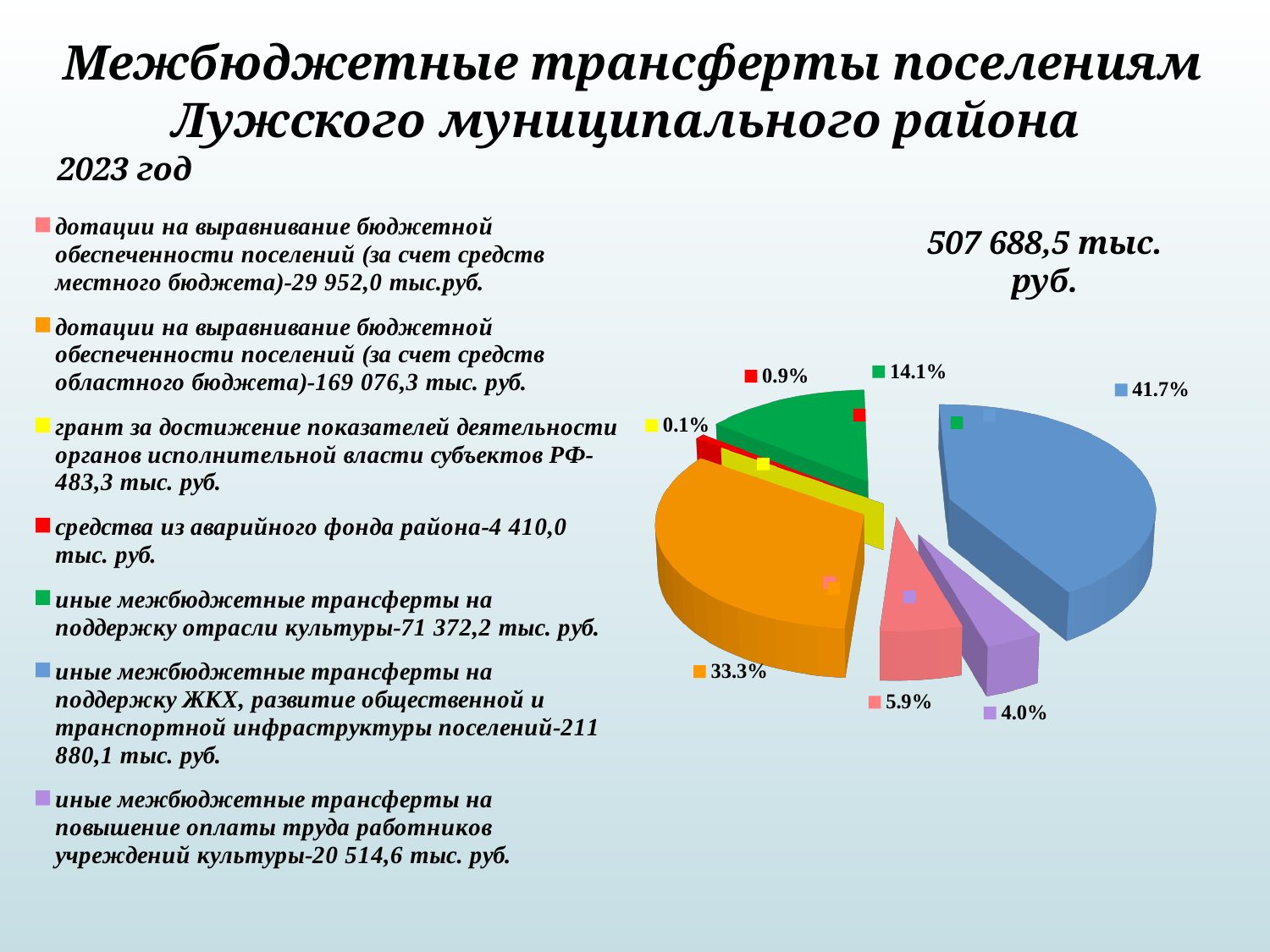
What type of chart is shown on the slide? pie chart Which category has the largest slice of the pie? иные межбюджетные трансферты на поддержку ЖКХ, развитие общественной и транспортной инфраструктуры поселений What amount in тыс. руб. does the legend give for 'средства из аварийного фонда района'? 4 410,0 тыс. руб. What share of the pie is labelled for 'иные межбюджетные трансферты на поддержку отрасли культуры'? 14.1% What is the difference in percentage points between the largest slice (41.7%) and the second largest slice (33.3%)? 8.4 What share of the pie is labelled for 'дотации на выравнивание бюджетной обеспеченности поселений (за счет средств областного бюджета)'? 33.3% What total amount in тыс. руб. is shown above the pie chart? 507 688,5 тыс. руб. What share of the pie is labelled for 'средства из аварийного фонда района'? 0.9% How many slices does the pie chart have? 7 Which slice is larger: 'дотации на выравнивание бюджетной обеспеченности поселений (за счет средств местного бюджета)' or 'иные межбюджетные трансферты на повышение оплаты труда работников учреждений культуры'? дотации на выравнивание бюджетной обеспеченности поселений (за счет средств местного бюджета) Which category has the smallest slice of the pie? грант за достижение показателей деятельности органов исполнительной власти субъектов РФ